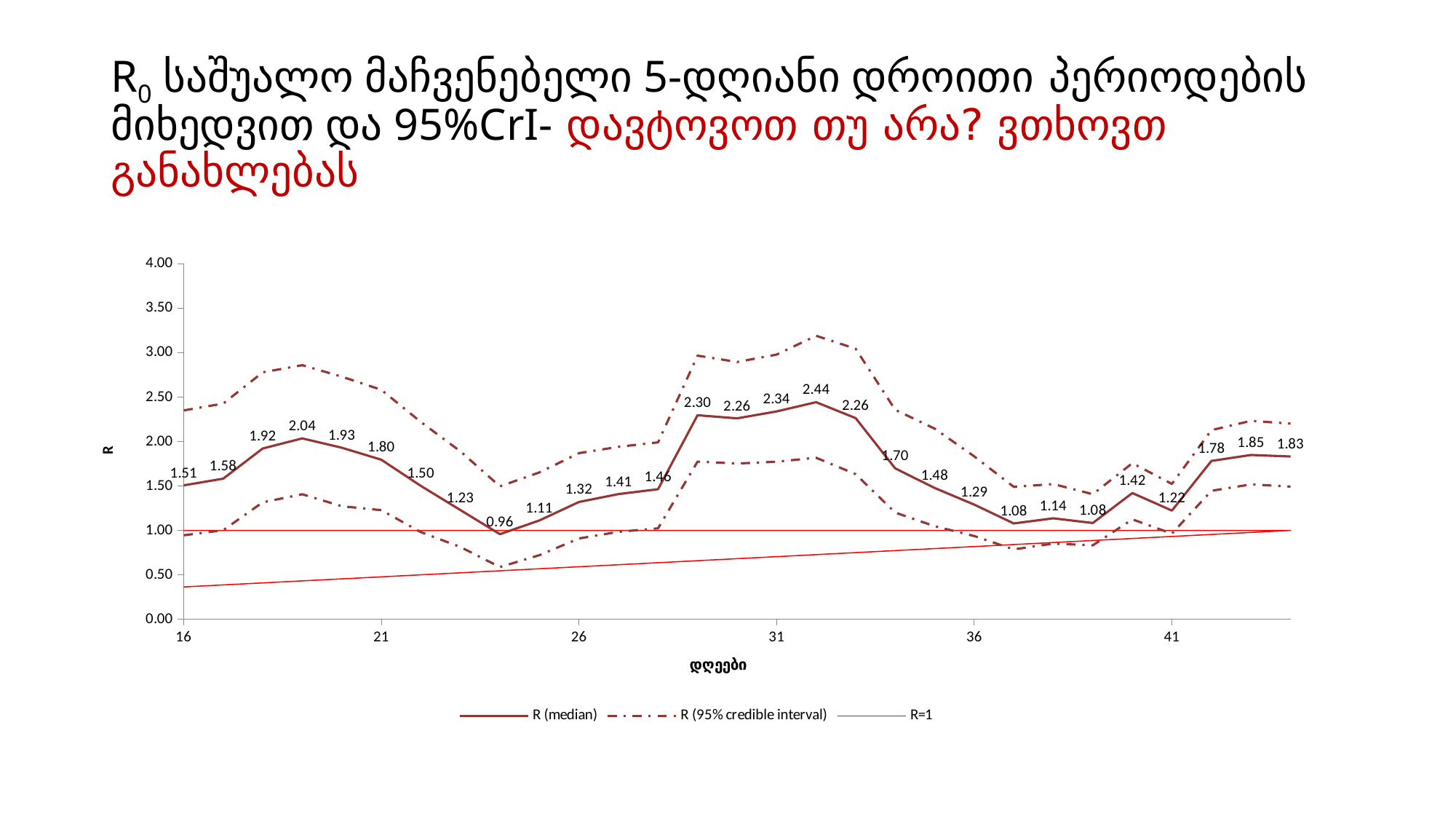
What is the R (median) value at day 16? 1.51 What is the lowest R (median) value labelled on the chart? 0.96 What is the R (median) value at day 41? 1.22 What type of chart is shown on the slide? line chart What is the difference between the highest labelled R (median) value (2.44) and the lowest (0.96)? 1.48 What is the R (median) value at day 31? 2.34 What is the highest R (median) value labelled on the chart? 2.44 How many R (median) data points are labelled on the chart? 29 What is the label of the third legend entry? R=1 How many series does the legend list? 3 Which is larger, the R (median) value at day 26 (1.32) or at day 36 (1.29)? day 26 (1.32) What is the R (median) value at day 21? 1.80